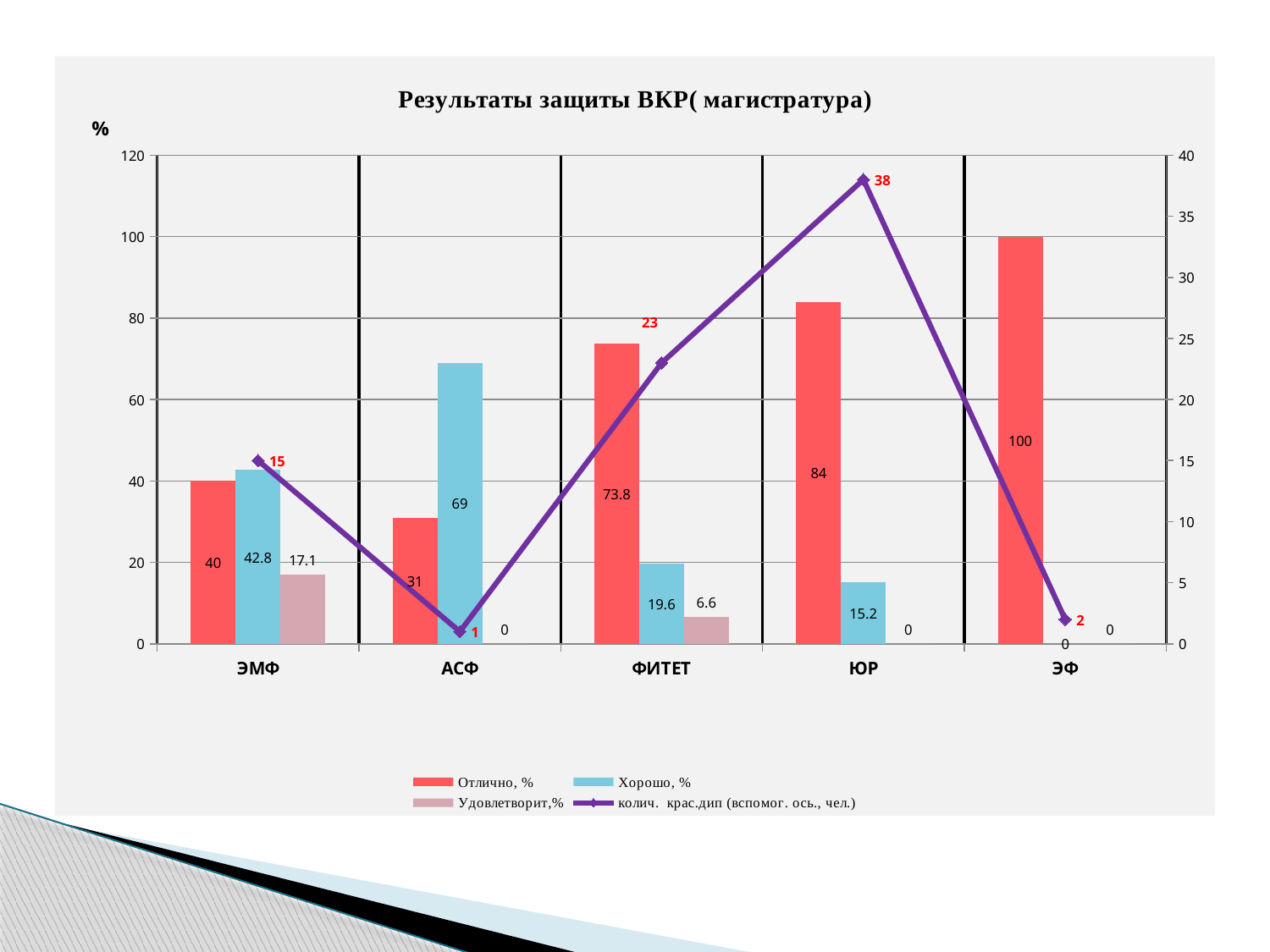
What is the title of the chart? Результаты защиты ВКР( магистратура) What is the value of Удовлетворит,% for ЭМФ? 17.1 Which is larger for ЭМФ: Отлично, % or Хорошо, %? Хорошо, % How many categories are shown on the x axis? 5 What is the difference between Отлично, % for ЮР and Отлично, % for АСФ? 53 What kind of chart is this? Combined bar and line chart How many series does the legend list? 4 What is the value of Отлично, % for ФИТЕТ? 73.8 What is the value of the колич. крас.дип line for ЮР? 38 Which category has the highest value of Отлично, %? ЭФ Which category has the lowest value on the колич. крас.дип line? АСФ What is the value of Хорошо, % for АСФ? 69